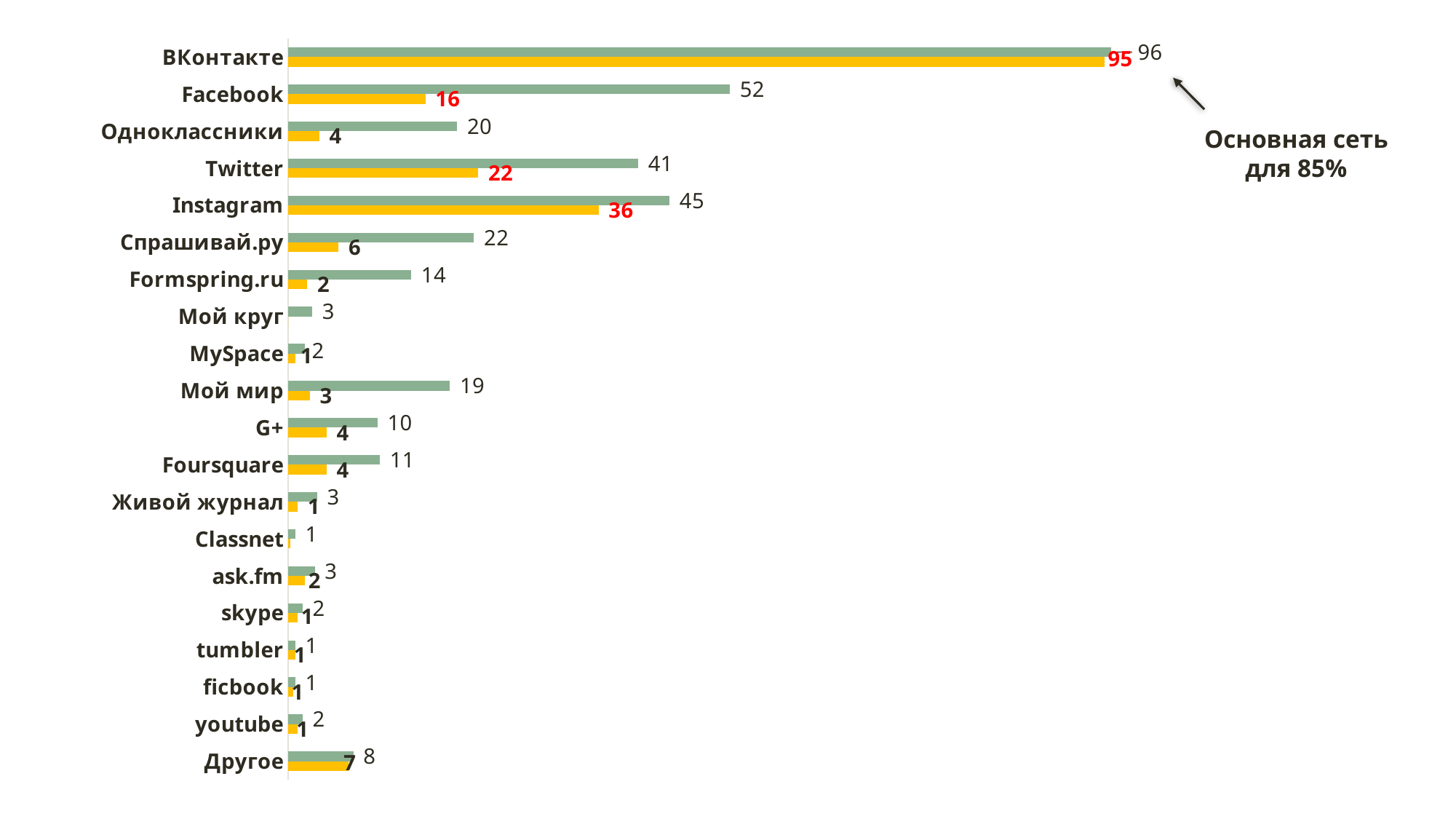
What is the value of the yellow bar for Twitter? 22 What is the value of the green bar for ВКонтакте? 96 What kind of chart is shown on the slide? Bar chart Which has a larger yellow bar value, Instagram or Facebook? Instagram What is the difference between the green and yellow bar values for Facebook? 36 What is the value of the yellow bar for Другое? 7 What is the difference between the green bar values for Instagram and Twitter? 4 Which has a larger green bar value, Одноклассники or Спрашивай.ру? Спрашивай.ру What is the value of the yellow bar for Instagram? 36 What is the value of the green bar for Facebook? 52 How many categories are shown on the chart? 20 Which category has the highest green bar value? ВКонтакте